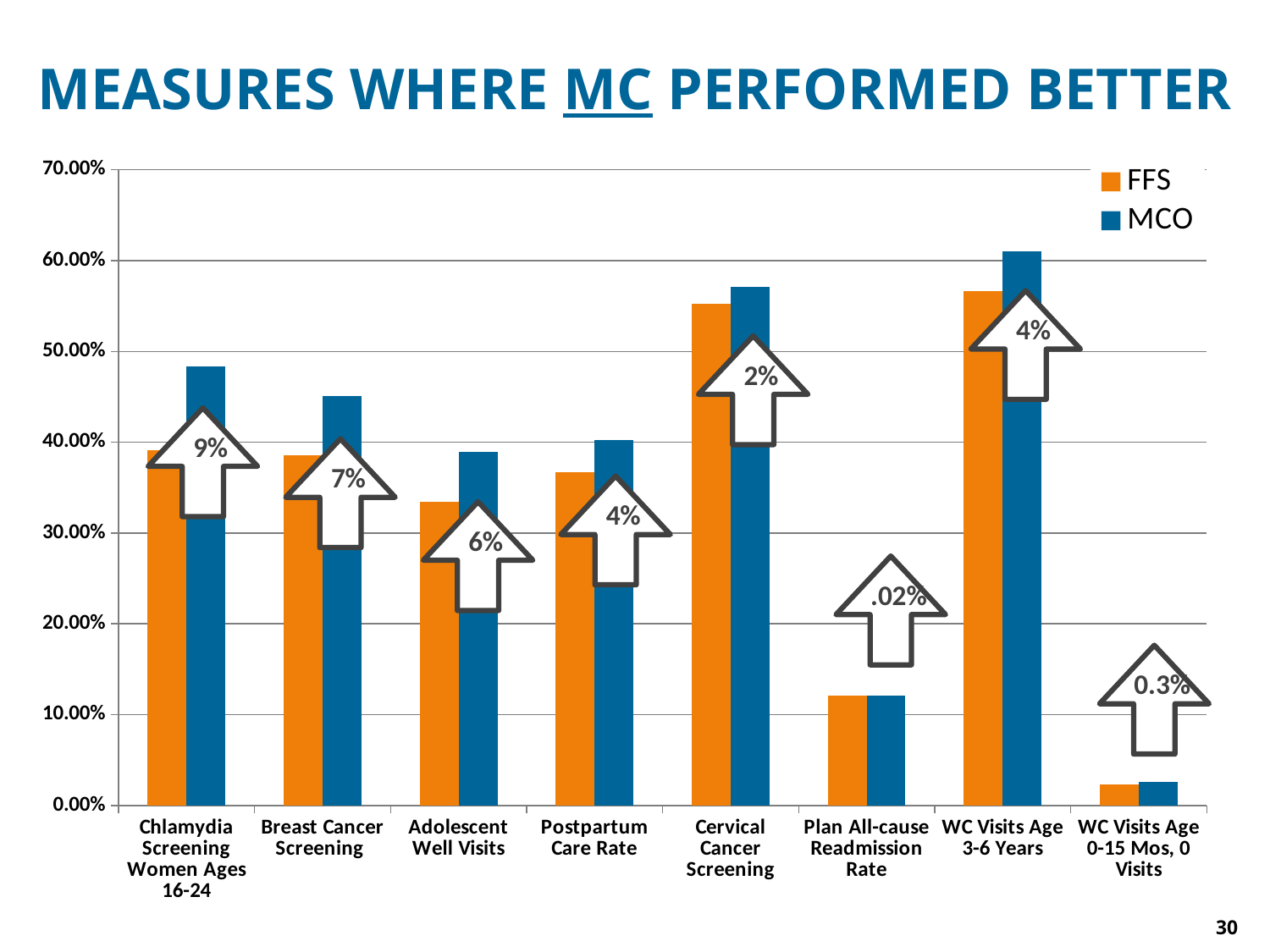
How many series does the legend list? 2 Which is larger: the MCO value for Chlamydia Screening Women Ages 16-24 or the MCO value for Breast Cancer Screening? Chlamydia Screening Women Ages 16-24 Is the FFS value for Cervical Cancer Screening greater or less than 50.00%? greater Which measure has the lowest MCO value? WC Visits Age 0-15 Mos, 0 Visits Which measure has the lowest FFS value? WC Visits Age 0-15 Mos, 0 Visits What kind of chart is shown on the slide? Bar chart How many measures (categories) are shown along the x axis? 8 Is the FFS value for Adolescent Well Visits greater or less than 40.00%? less Is the MCO value for Plan All-cause Readmission Rate greater or less than 20.00%? less Which colour represents the MCO series in the legend? Blue Which measure has the highest MCO value? WC Visits Age 3-6 Years